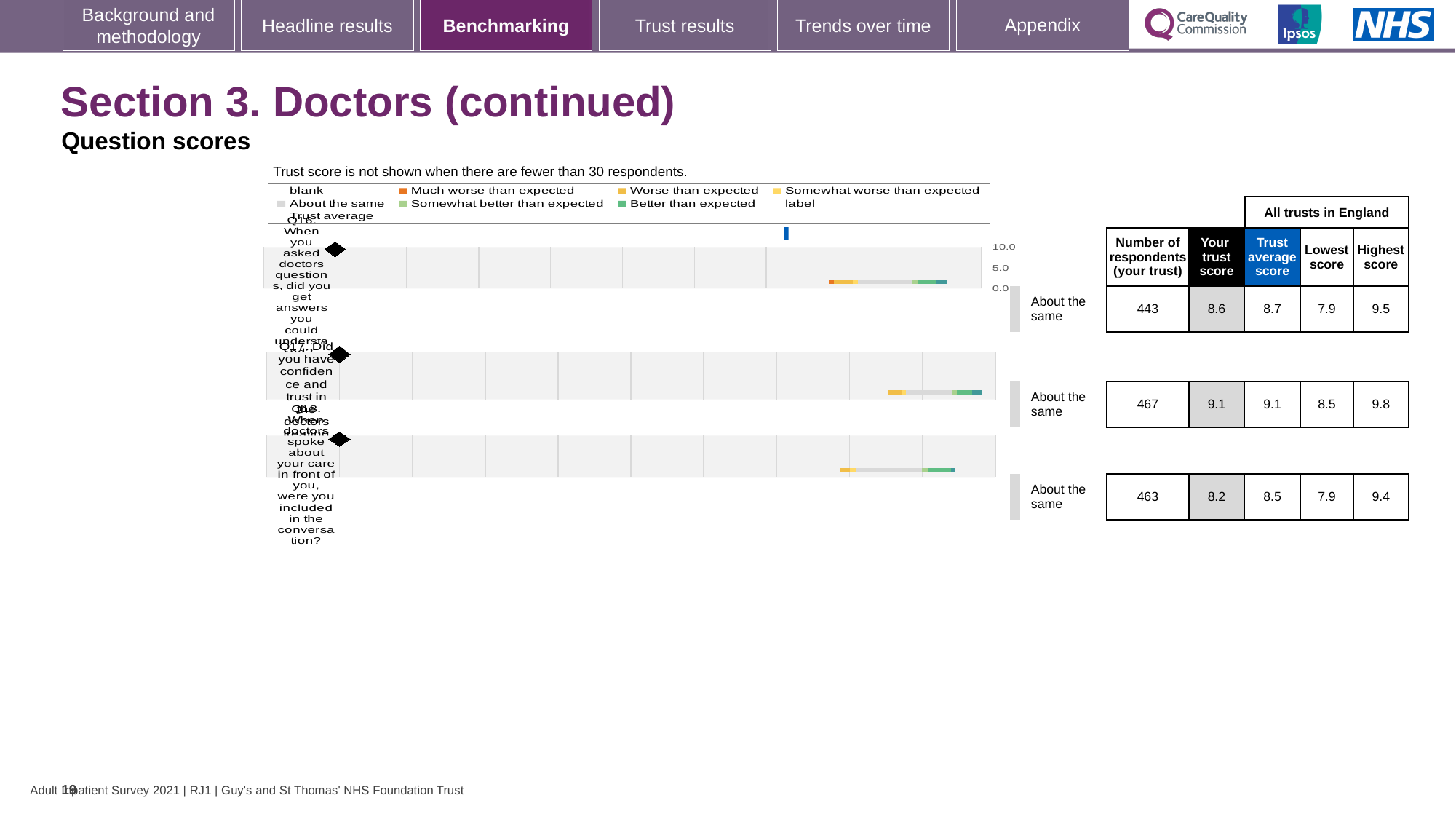
What kind of chart is used to show the question scores? Bar chart What benchmark category is shown next to each of the three questions? About the same Which is larger: your trust score for Q16 or for Q18? Q16 Which question has the lowest 'Your trust score'? Q18 What is the highest score across all trusts in England for Q17? 9.8 How many respondents from your trust answered Q16? 443 Which question has the highest 'Your trust score'? Q17 For Q18, what is the difference between the trust average score and your trust score? 0.3 What is the lowest score across all trusts in England for Q16? 7.9 How many questions are plotted on the chart? 3 What is your trust score for Q17 (confidence and trust in the doctors)? 9.1 What is the trust average score for Q18? 8.5